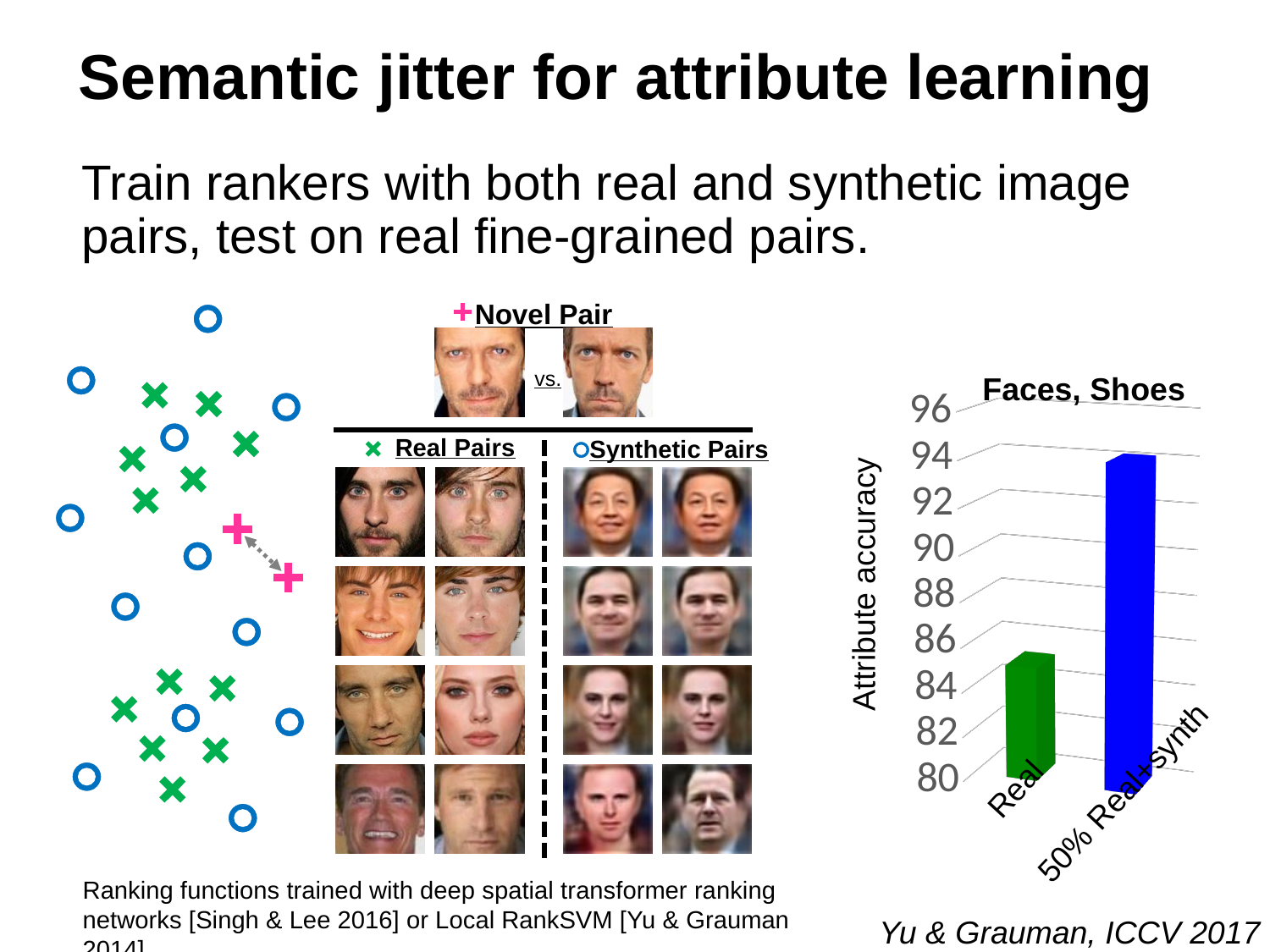
What is the y-axis label of the chart on the right of the slide? Attribute accuracy What is the title of the chart on the right of the slide? Faces, Shoes How many bars are plotted in the chart on the right of the slide? 2 In the chart on the right, is the value for Real greater or less than 88? less In the chart on the right, which category has the lowest attribute accuracy? Real In the chart on the right, is the value for Real greater or less than 90? less In the chart on the right, is the value for 50% Real+Synth greater or less than 96? less What kind of chart is shown on the right of the slide? bar chart In the chart on the right, which is larger: the attribute accuracy for Real or for 50% Real+Synth? 50% Real+Synth In the chart on the right, which category has the highest attribute accuracy? 50% Real+Synth